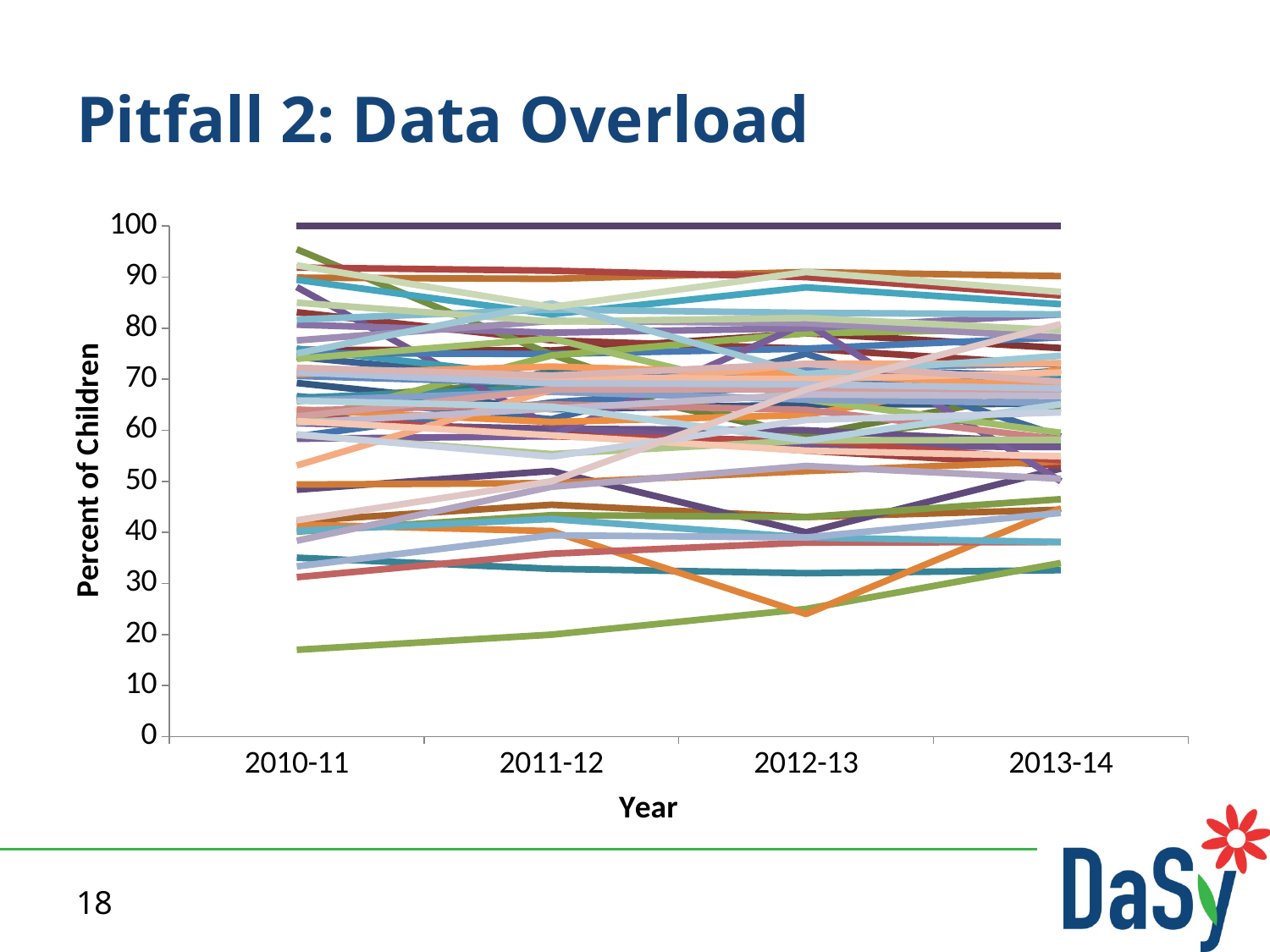
What kind of chart is shown on the slide? line chart How many years are shown along the x axis of the chart? 4 What is the maximum value shown on the y axis? 100 Is the value of the lowest line in 2013-14 greater or less than 30? greater What is the first year shown on the x axis? 2010-11 What is the label on the y axis of the chart? Percent of Children What is the title of the slide containing the chart? Pitfall 2: Data Overload Is the value of the lowest line in 2010-11 greater or less than 20? less What is the last year shown on the x axis? 2013-14 What value does the topmost line hold across all four years? 100 Does the lowest line on the chart rise or fall from 2010-11 to 2013-14? rise